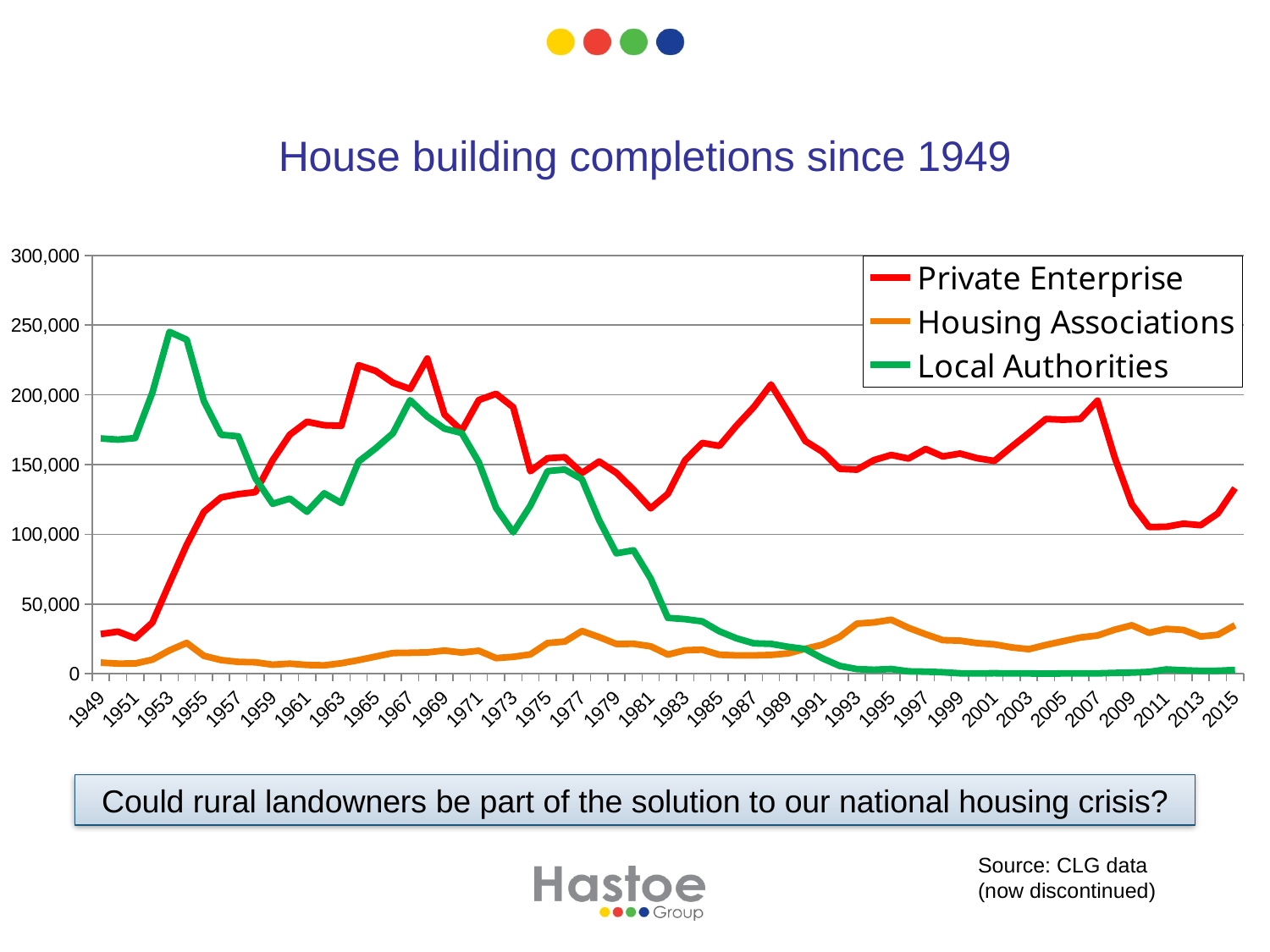
Does the Local Authorities line rise or fall between 1977 and 1993? fall How many series does the legend list? 3 Is the value for Local Authorities in 1953 greater or less than 200,000? greater In 1953, which series has the higher value, Private Enterprise or Local Authorities? Local Authorities What kind of chart is shown on the slide? line chart Which series reaches the highest value anywhere on the chart? Local Authorities What is the title of the chart? House building completions since 1949 Is the value for Housing Associations in 1995 greater or less than 50,000? less Is the value for Private Enterprise in 1987 greater or less than 150,000? greater What colour is the Local Authorities line? green In 2015, which series has the higher value, Private Enterprise or Local Authorities? Private Enterprise